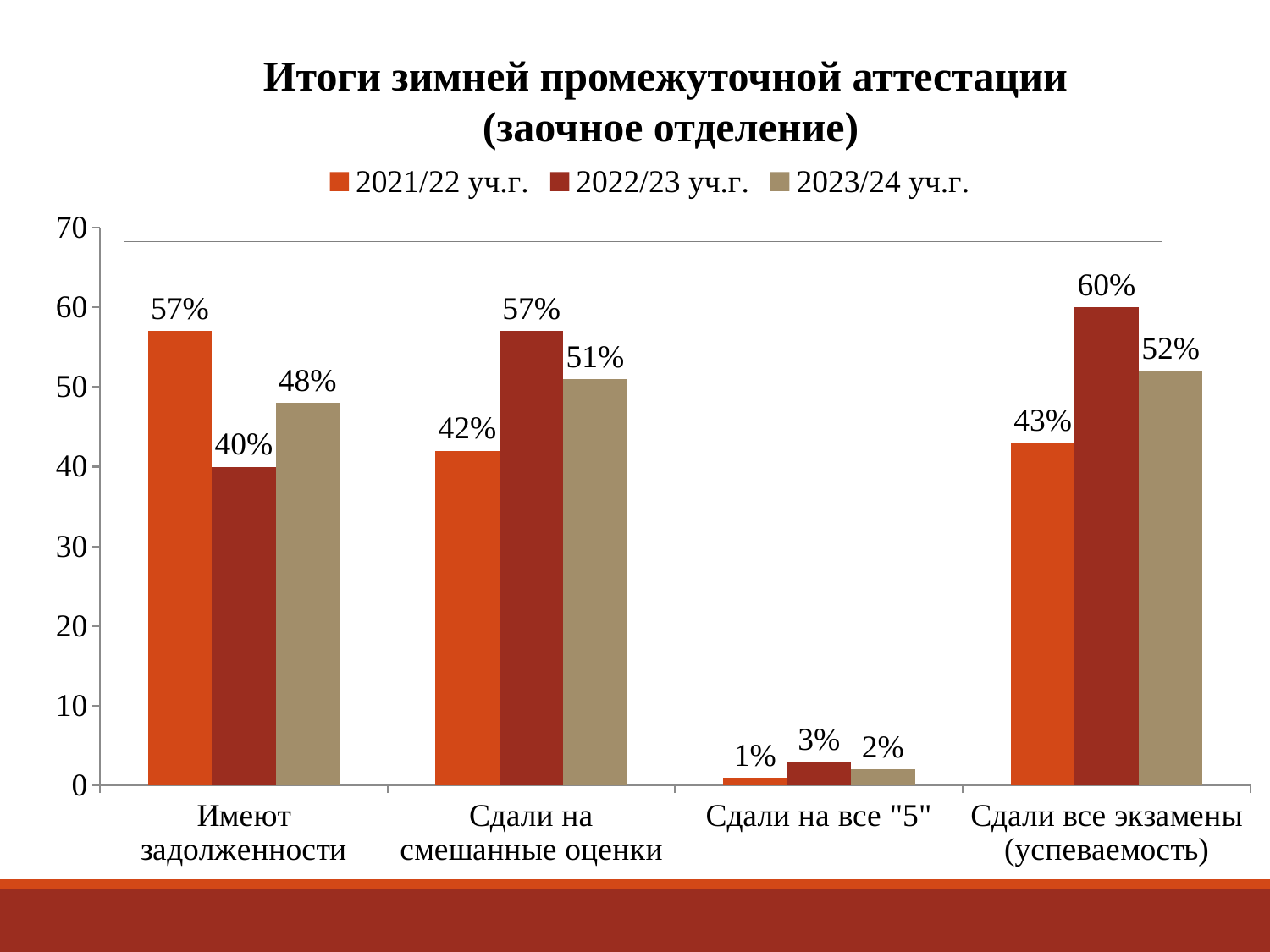
What is the title of the chart? Итоги зимней промежуточной аттестации (заочное отделение) Is the value for "Имеют задолженности" in the 2023/24 уч.г. series greater or less than 40? greater What is the difference between the 2022/23 уч.г. and 2021/22 уч.г. values for "Сдали все экзамены (успеваемость)"? 17% How many series does the legend list? 3 Which category has the lowest value in the 2021/22 уч.г. series? Сдали на все "5" What is the value for "Сдали на все "5"" in the 2023/24 уч.г. series? 2% For "Сдали на смешанные оценки", which is larger: the 2022/23 уч.г. value or the 2023/24 уч.г. value? 2022/23 уч.г. Which category has the highest value in the 2022/23 уч.г. series? Сдали все экзамены (успеваемость) What kind of chart is shown on the slide? Bar chart What is the value for "Сдали все экзамены (успеваемость)" in the 2022/23 уч.г. series? 60% What is the value for "Имеют задолженности" in the 2021/22 уч.г. series? 57% How many categories are shown on the x axis? 4